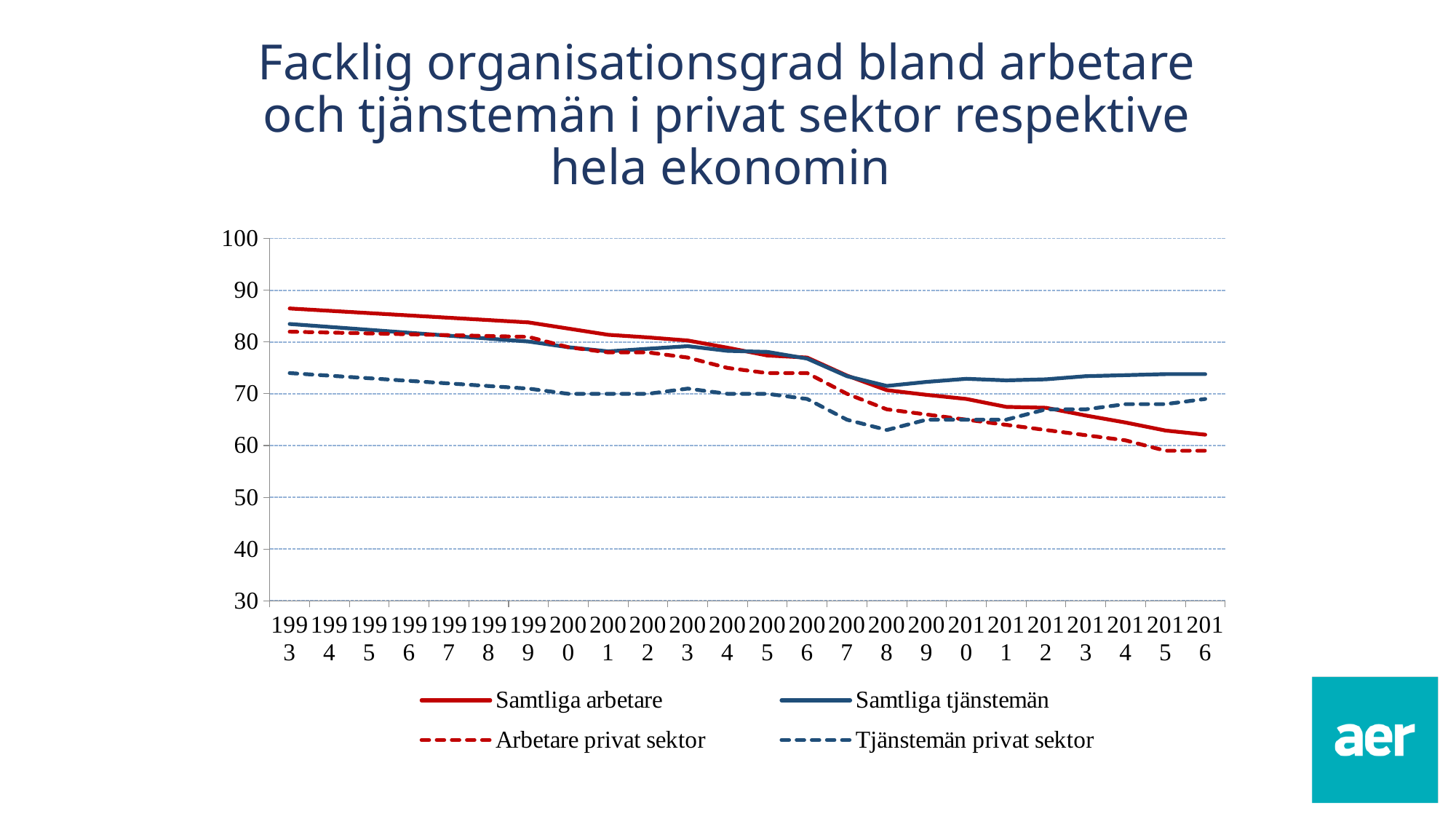
Does the value for Samtliga arbetare rise or fall from 1993 to 2016? Fall Which series has the highest value in 1993? Samtliga arbetare Which series has the lowest value in 1993? Tjänstemän privat sektor How many years are plotted along the x axis? 24 Which series is drawn as a solid red line? Samtliga arbetare Is the value for Samtliga arbetare in 1993 greater or less than 80? greater What kind of chart is shown on the slide? Line chart In 2016, which is larger: Samtliga tjänstemän or Samtliga arbetare? Samtliga tjänstemän What is the first year shown on the x axis? 1993 Is the value for Tjänstemän privat sektor in 2008 greater or less than 70? less How many series does the legend list? 4 Is the value for Samtliga tjänstemän in 2016 greater or less than 70? greater